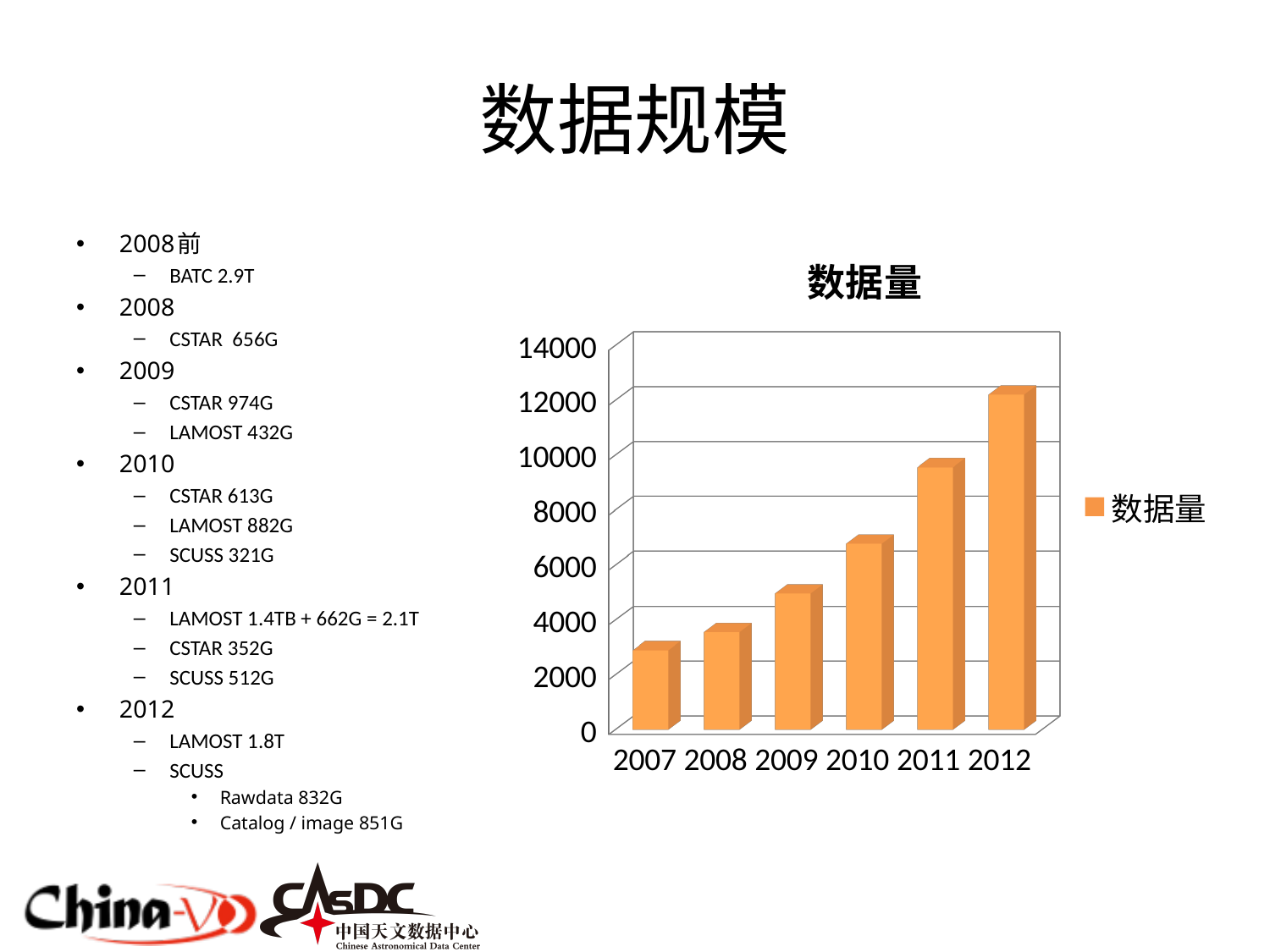
What colour are the bars in the chart? orange What is the title of the chart? 数据量 How many series does the chart legend list? 1 Is the value for 2008 greater or less than 4000? less Which is larger, the value for 2011 or the value for 2009? 2011 Do the values rise or fall from 2007 to 2012? rise Which year has the highest value in the chart? 2012 Is the value for 2010 greater or less than 6000? greater Is the value for 2012 greater or less than 10000? greater What kind of chart is shown on the slide? bar chart Which year has the lowest value in the chart? 2007 How many years are shown on the x axis of the chart? 6